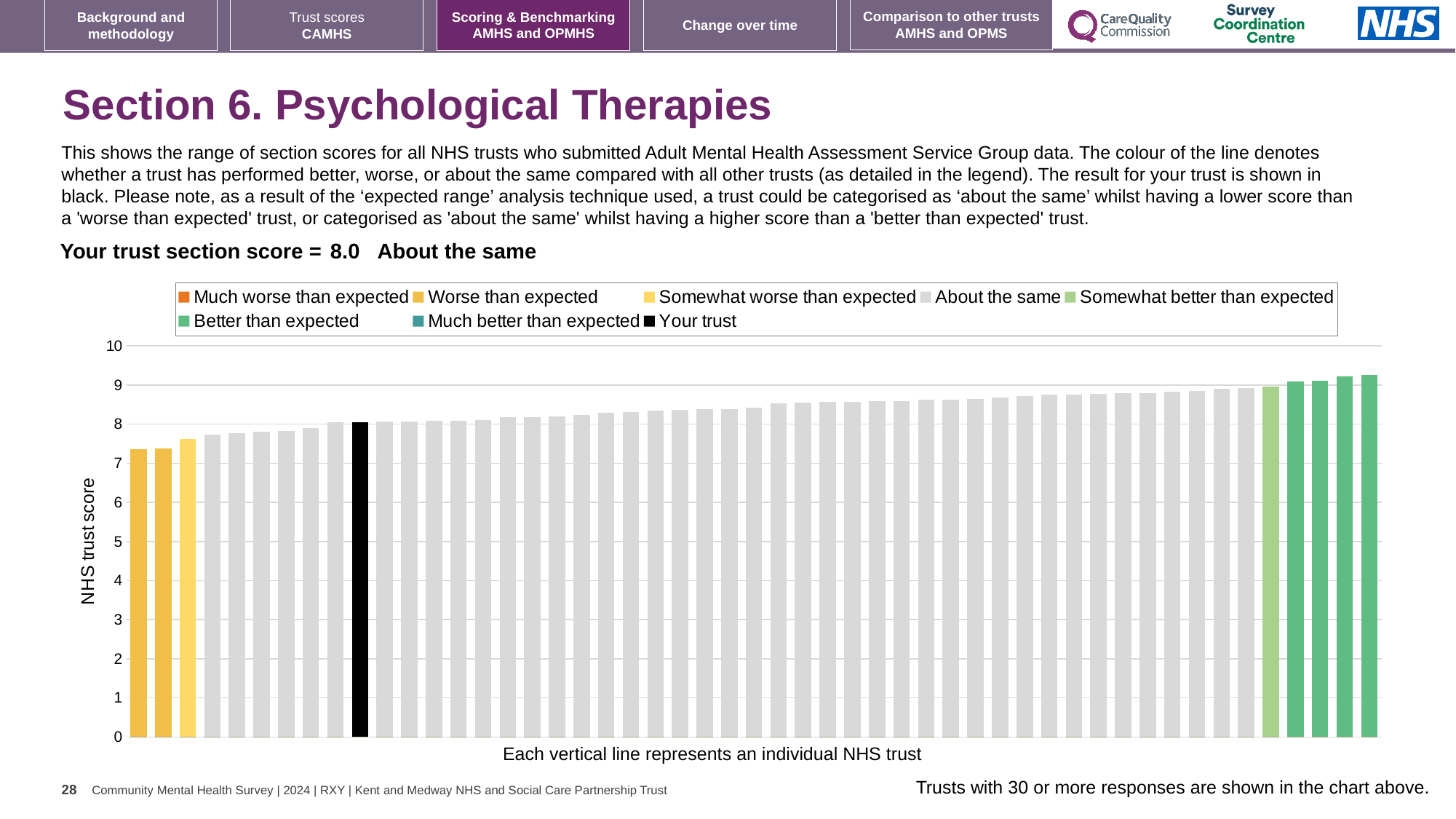
Which legend category do the tallest bars in the chart belong to? Better than expected What kind of chart is shown on the slide? bar chart How many entries does the chart legend list? 8 How many bars are coloured as 'Worse than expected' (orange-yellow)? 2 Is the value for your trust (the black bar) greater or less than 5? greater Is the value of the highest bar in the chart greater or less than 9? greater Do the bar values rise or fall from left to right along the x axis? rise Is the value of the lowest bar in the chart greater or less than 8? less How many bars are coloured as 'Better than expected' (green)? 4 What is the label on the vertical axis of the chart? NHS trust score Which performance category is your trust placed in for this section? About the same What is the section score for your trust shown on the slide? 8.0